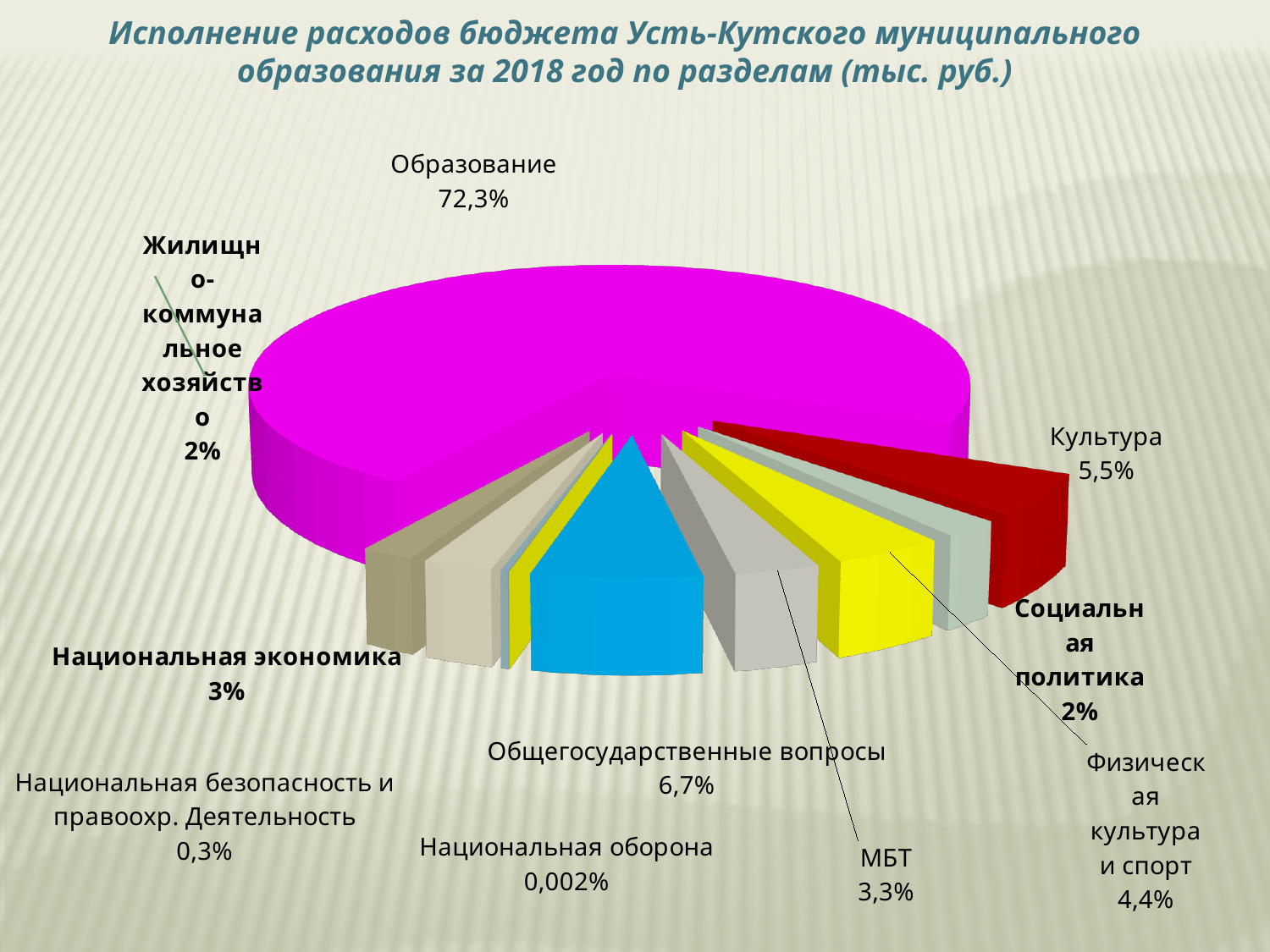
What is the value shown for Культура? 5,5% What is the value shown for Национальная оборона? 0,002% What is the difference between the shares of Общегосударственные вопросы and Культура? 1,2% What is the value shown for Физическая культура и спорт? 4,4% What year does the chart title say the budget expenditure data is for? 2018 Which category has the largest share of the pie? Образование What is the value shown for Общегосударственные вопросы? 6,7% Which is larger, the share for МБТ or the share for Физическая культура и спорт? Физическая культура и спорт How many categories are shown in the pie chart? 10 Which category has the smallest share of the pie? Национальная оборона What kind of chart is shown on the slide? pie chart What share of the pie does Образование have? 72,3%